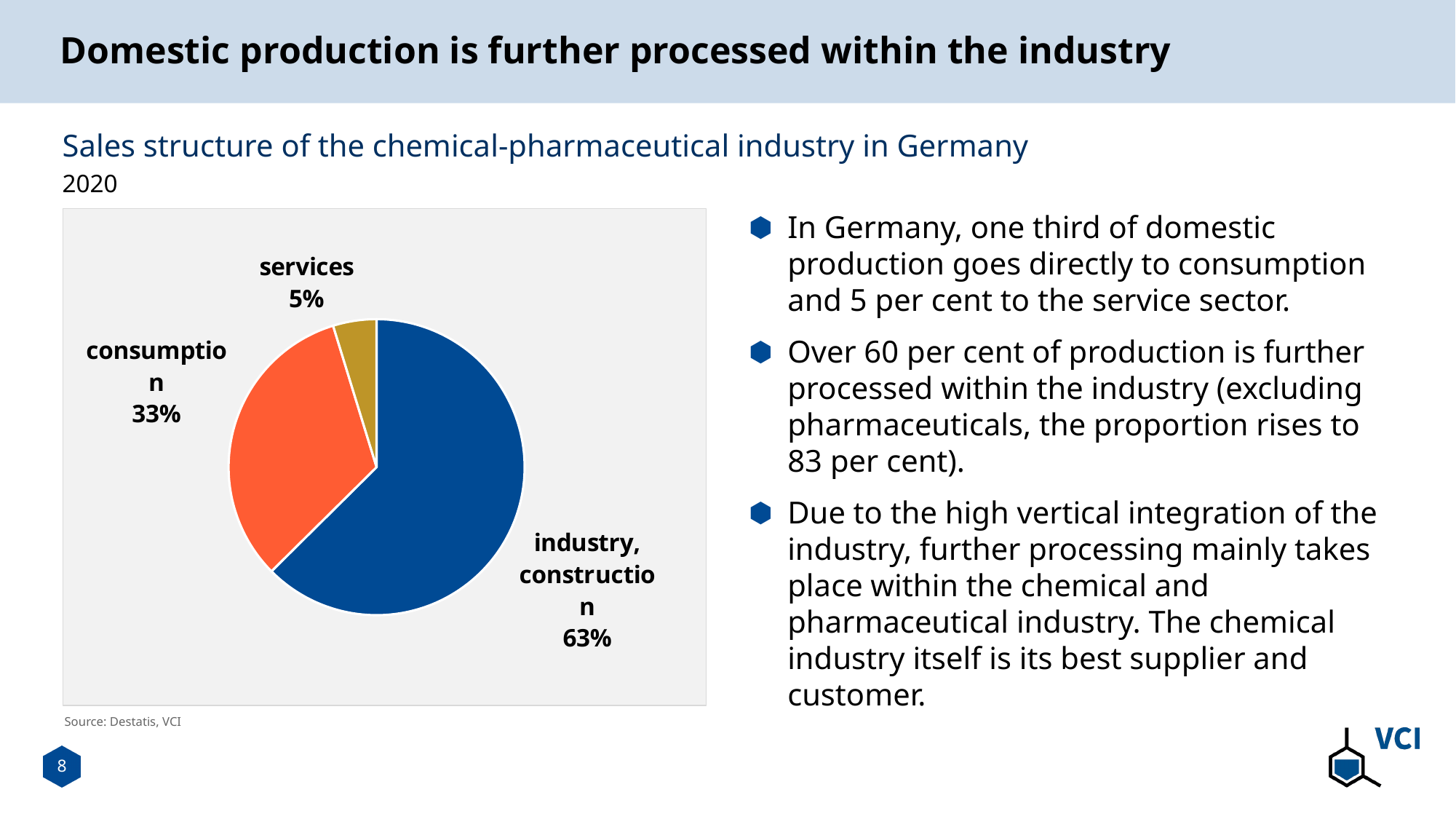
How many slices does the pie chart have? 3 Which category has the smallest share of the pie? services What share of sales goes to industry, construction? 63% Which year does the chart refer to? 2020 What kind of chart is shown on the slide? pie chart What share of sales goes to consumption? 33% What share of sales goes to services? 5% What is the difference in percentage points between the consumption share and the services share? 28 percentage points Which category has the largest share of the pie? industry, construction What is the title of the chart? Sales structure of the chemical-pharmaceutical industry in Germany What is the difference in percentage points between the industry, construction share and the consumption share? 30 percentage points Which is larger, the share for consumption or the share for services? consumption